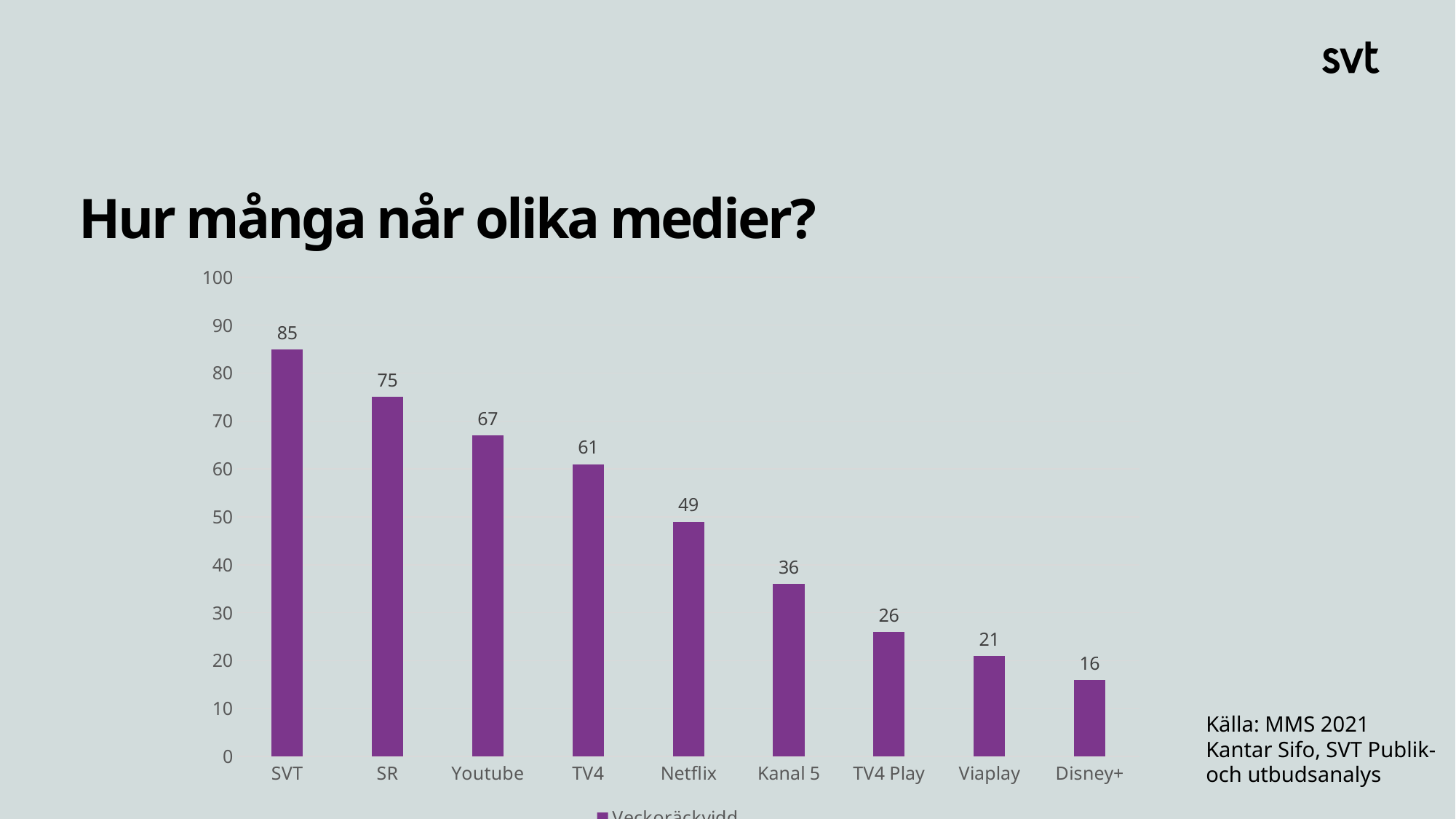
Which category has the highest value? SVT Which is larger, the value for Youtube or the value for Netflix? Youtube What is the difference between the values for SR and TV4? 14 What is the value for SVT? 85 What kind of chart is shown on the slide? bar chart How many categories are shown on the x axis? 9 Do the values rise or fall from left to right along the x axis? fall What is the difference between the values for Kanal 5 and TV4 Play? 10 Is the value for TV4 greater or less than 50? greater What is the value for Viaplay? 21 Which category has the lowest value? Disney+ What is the value for Netflix? 49